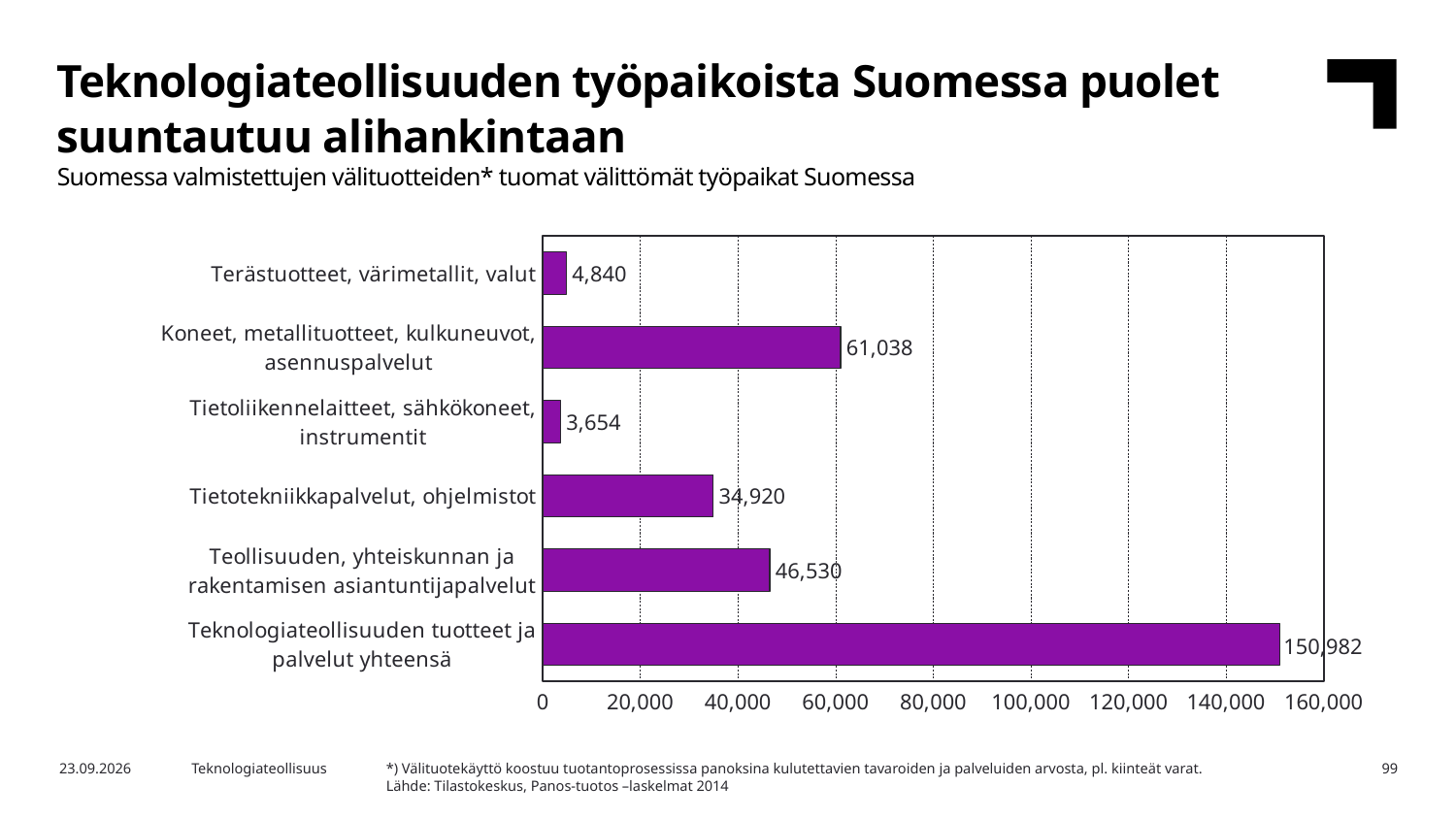
What is the value for Terästuotteet, värimetallit, valut? 4,840 Which is larger: Teollisuuden, yhteiskunnan ja rakentamisen asiantuntijapalvelut or Tietotekniikkapalvelut, ohjelmistot? Teollisuuden, yhteiskunnan ja rakentamisen asiantuntijapalvelut Which category has the lowest value? Tietoliikennelaitteet, sähkökoneet, instrumentit What is the difference between Koneet, metallituotteet, kulkuneuvot, asennuspalvelut and Tietotekniikkapalvelut, ohjelmistot? 26,118 What is the difference between Terästuotteet, värimetallit, valut and Tietoliikennelaitteet, sähkökoneet, instrumentit? 1,186 What is the value for Tietotekniikkapalvelut, ohjelmistot? 34,920 What kind of chart is shown on the slide? Bar chart What is the value for Koneet, metallituotteet, kulkuneuvot, asennuspalvelut? 61,038 Which category has the highest value? Teknologiateollisuuden tuotteet ja palvelut yhteensä How many categories are shown in the chart? 6 What is the value for Teknologiateollisuuden tuotteet ja palvelut yhteensä? 150,982 Is the value for Koneet, metallituotteet, kulkuneuvot, asennuspalvelut greater or less than 60,000? greater